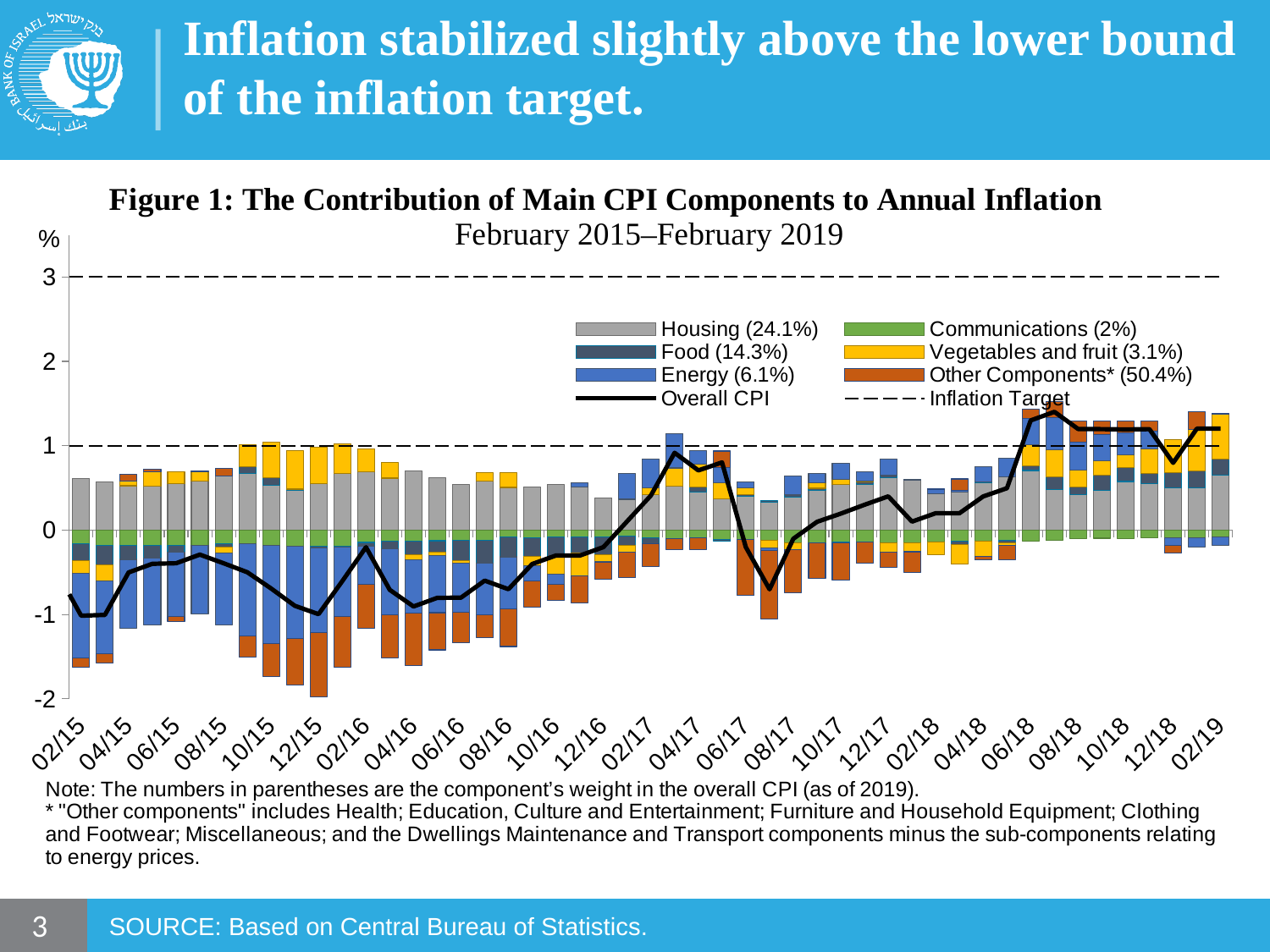
What kind of chart is Figure 1? Stacked bar chart with a line Which is larger, the Overall CPI at 02/19 or at 02/15? 02/19 Is the Overall CPI value at 12/18 greater or less than 1? less According to the legend, which component has the largest weight in the overall CPI? Other Components* (50.4%) What period does the subtitle of Figure 1 cover? February 2015–February 2019 How many date labels are shown on the x axis of Figure 1? 25 Is the Overall CPI value at 06/18 greater or less than 1? greater Is the Overall CPI value at 02/19 greater or less than 1? greater How many entries does the legend of Figure 1 list? 8